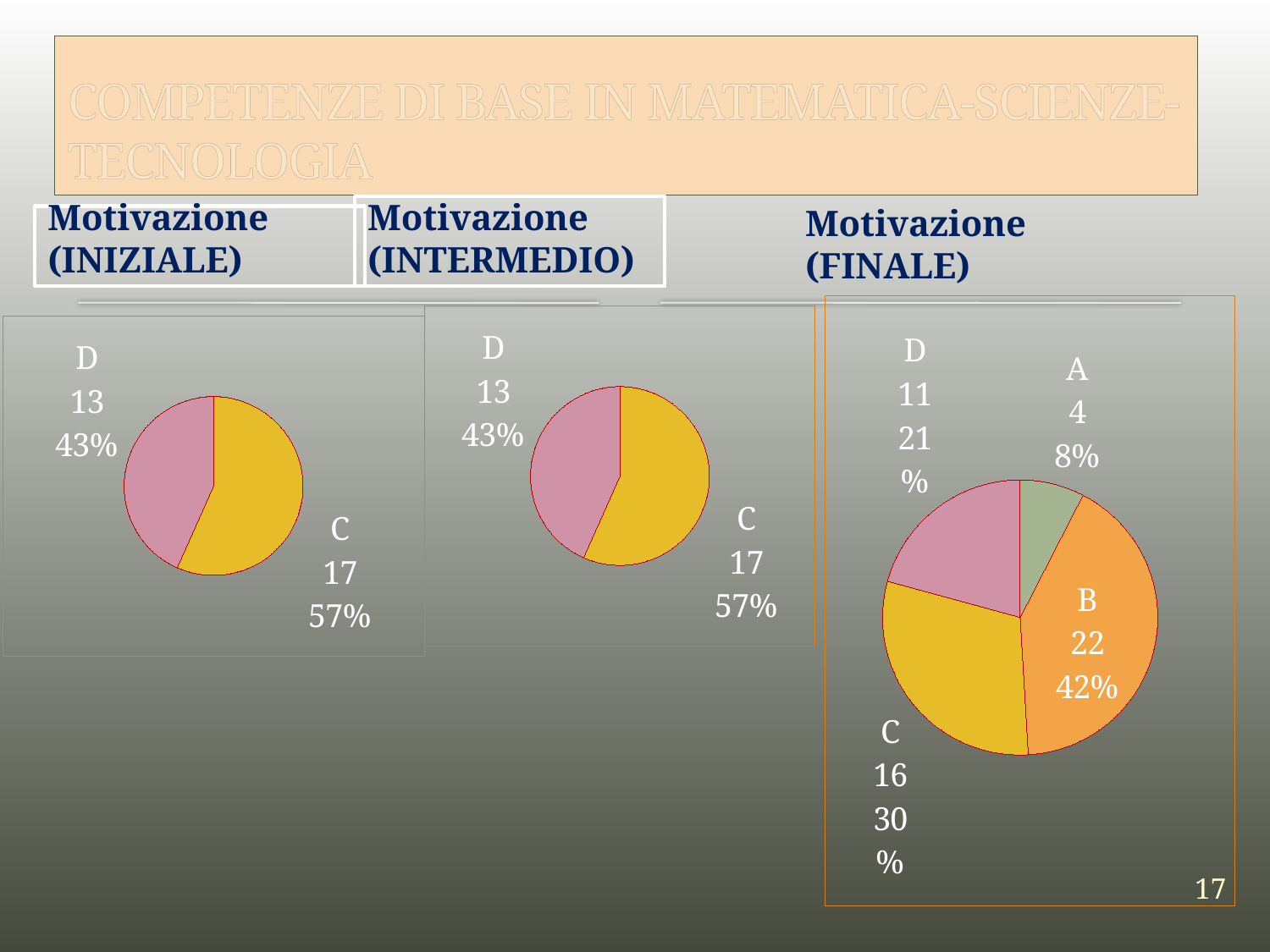
In the Motivazione (FINALE) pie chart, what is the difference between the values for B and C? 6 In the Motivazione (INIZIALE) pie chart, what share of the pie does category D have? 43% In the Motivazione (FINALE) pie chart, what share of the pie does category A have? 8% How many categories does the Motivazione (FINALE) pie chart show? 4 In the Motivazione (FINALE) pie chart, what is the value for category B? 22 In the Motivazione (FINALE) pie chart, which category has the largest slice? B In the Motivazione (INTERMEDIO) pie chart, what is the value for category D? 13 In the Motivazione (FINALE) pie chart, which is larger, the value for C or the value for D? C In the Motivazione (INIZIALE) pie chart, what is the value for category C? 17 What kind of chart is used for Motivazione (INIZIALE)? Pie chart In the Motivazione (FINALE) pie chart, which category has the smallest slice? A In the Motivazione (INTERMEDIO) pie chart, what share of the pie does category C have? 57%